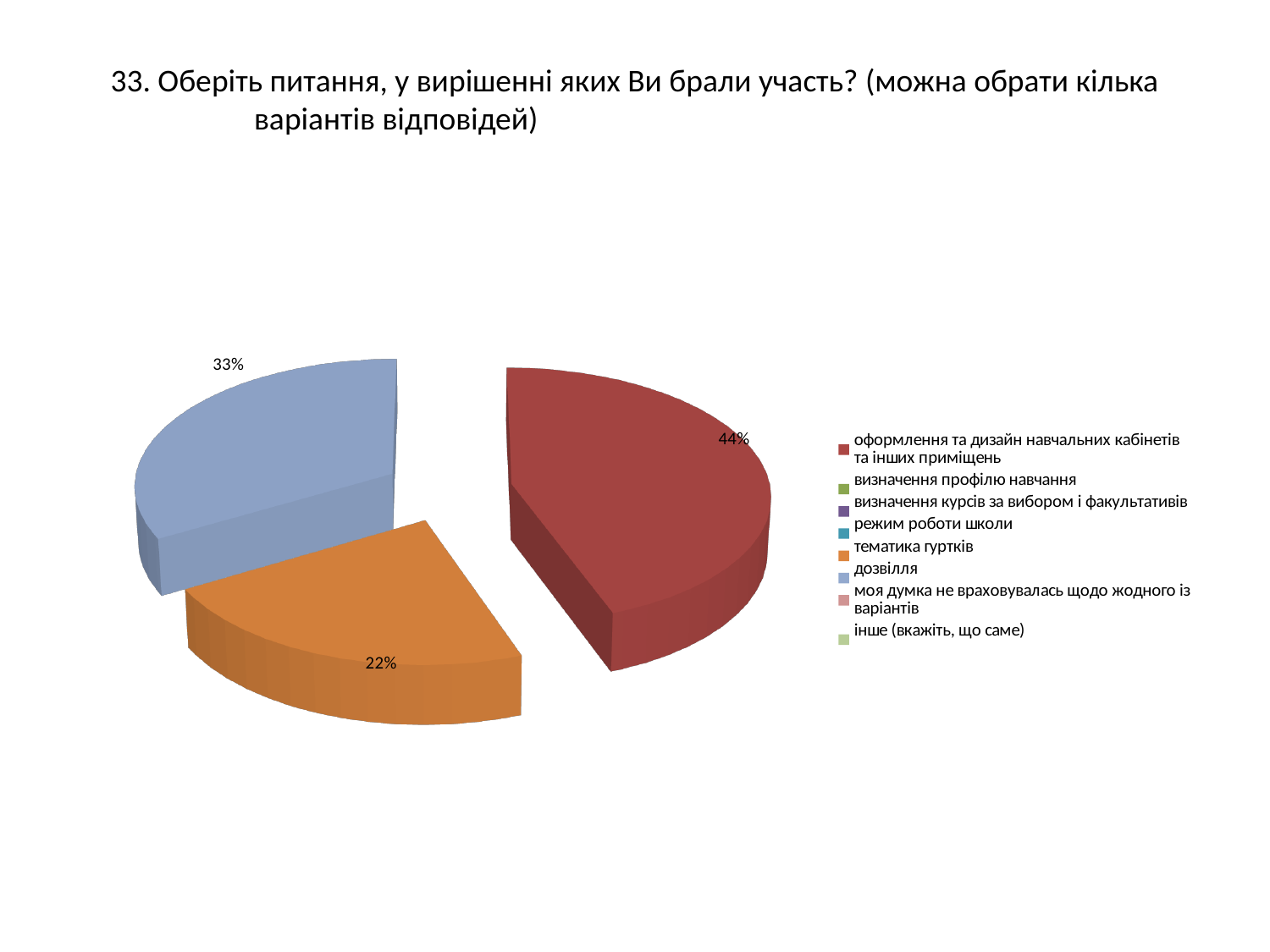
What is the difference in percentage points between the slices for "оформлення та дизайн навчальних кабінетів та інших приміщень" and "тематика гуртків"? 22 What share of the pie does the slice for "тематика гуртків" represent? 22% What kind of chart is shown on the slide? pie chart Which category has the largest slice of the pie? оформлення та дизайн навчальних кабінетів та інших приміщень Which slice is larger: "дозвілля" or "тематика гуртків"? дозвілля What colour is the slice for "дозвілля"? blue How many slices with data labels are visible in the pie? 3 What share of the pie does the slice for "оформлення та дизайн навчальних кабінетів та інших приміщень" represent? 44% How many entries does the legend list? 8 Which of the visible slices is the smallest? тематика гуртків What share of the pie does the slice for "дозвілля" represent? 33% What is the difference in percentage points between the slices for "дозвілля" and "тематика гуртків"? 11